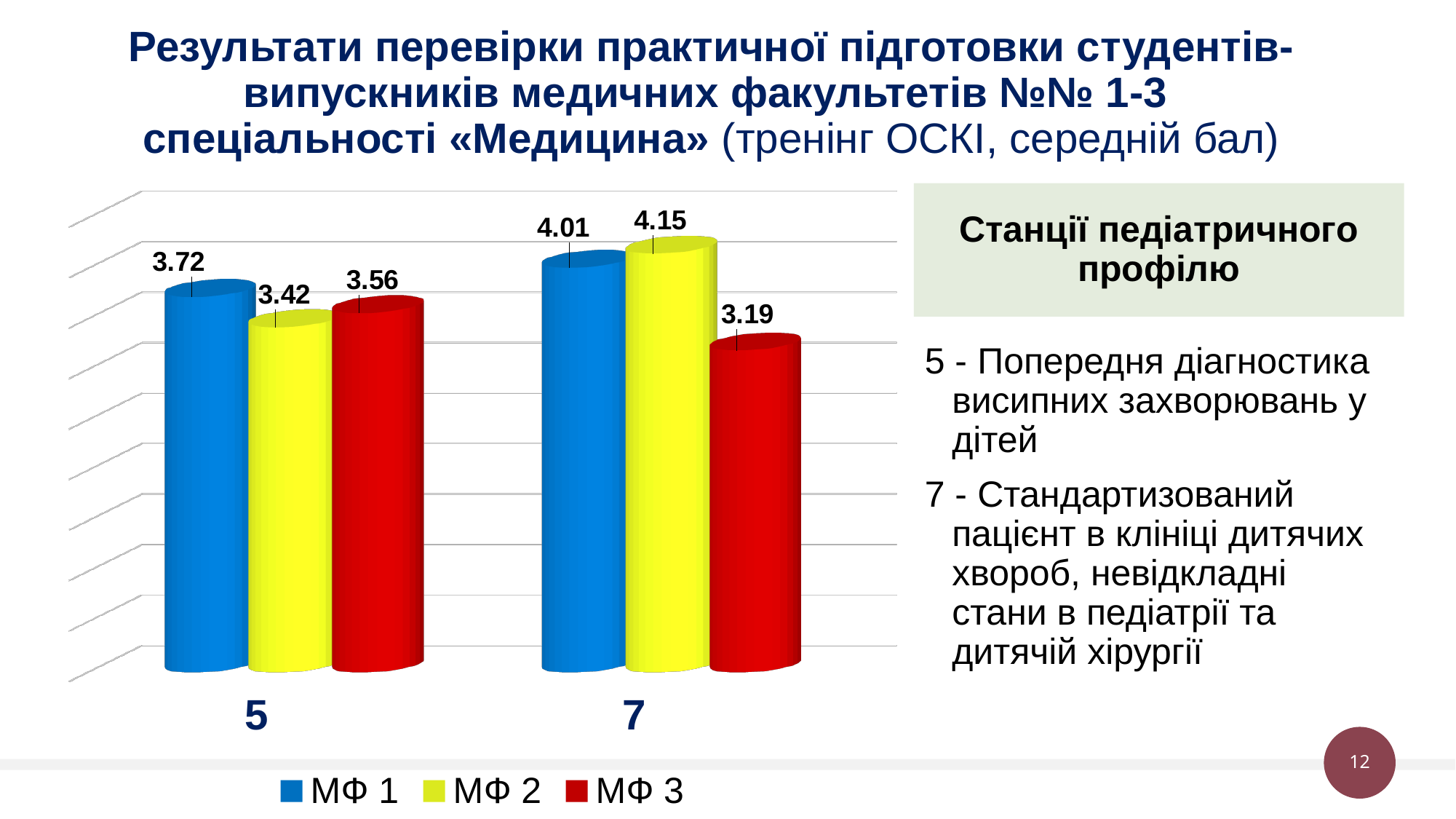
How many series does the legend list? 3 What is the difference between МФ 2 and МФ 3 at station 7? 0.96 What is the value for МФ 2 at station 5? 3.42 What is the difference between the МФ 1 values at station 7 and station 5? 0.29 Which series has the lowest value at station 5? МФ 2 How many categories (stations) are shown on the x axis? 2 What kind of chart is shown on the slide? Bar chart What is the value for МФ 3 at station 7? 3.19 What is the value for МФ 2 at station 7? 4.15 Which is larger at station 5: МФ 1 or МФ 3? МФ 1 Which series has the highest value at station 7? МФ 2 What is the value for МФ 1 at station 5? 3.72